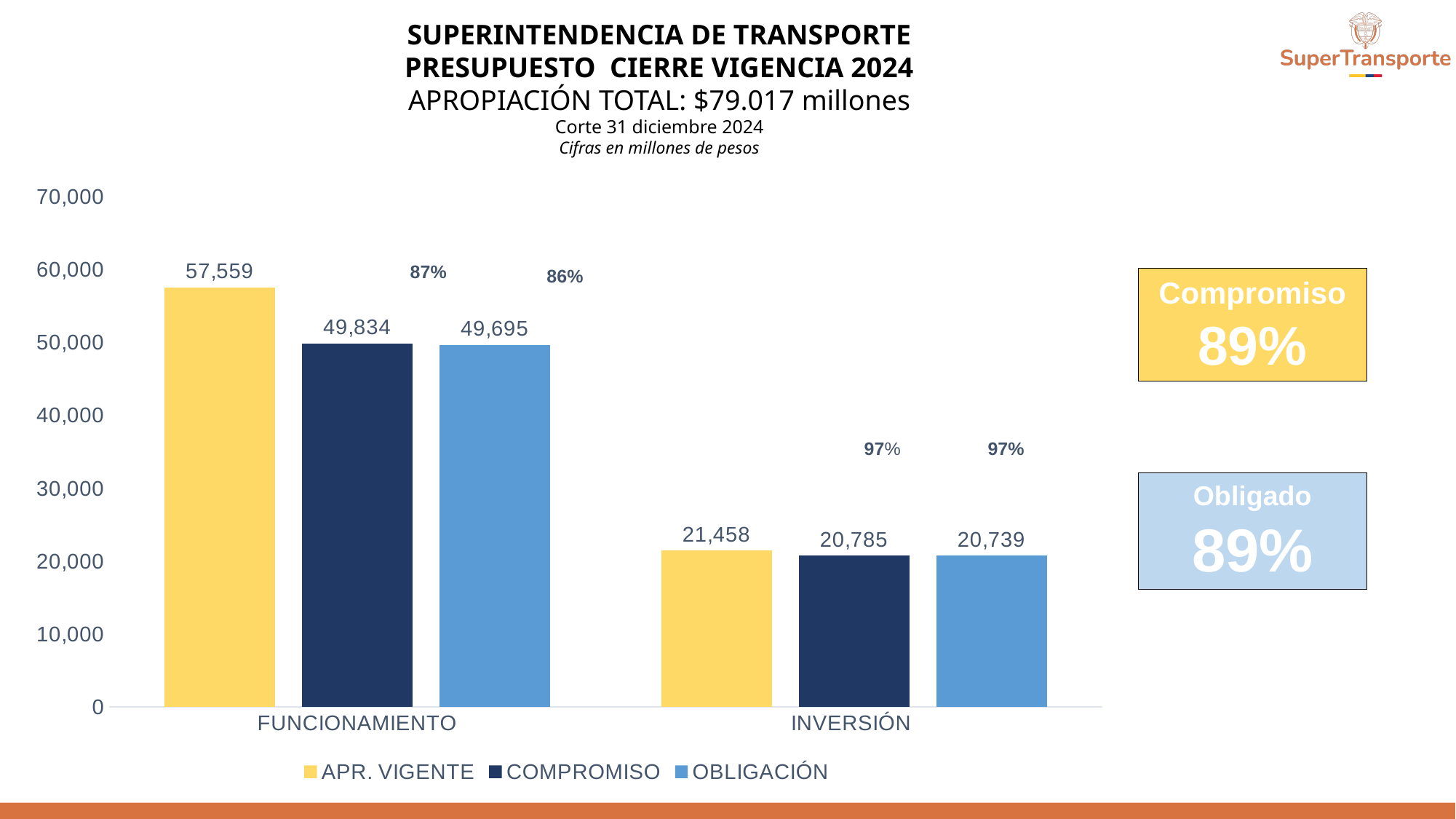
What is the OBLIGACIÓN value for FUNCIONAMIENTO? 49,695 What kind of chart is shown on the slide? Bar chart Which series has the lowest value for INVERSIÓN? OBLIGACIÓN How many series does the legend list? 3 How many categories are shown on the x axis? 2 What is the COMPROMISO value for INVERSIÓN? 20,785 Is the APR. VIGENTE value for INVERSIÓN greater or less than 20,000? greater What is the APR. VIGENTE value for FUNCIONAMIENTO? 57,559 What is the difference between the APR. VIGENTE and COMPROMISO values for FUNCIONAMIENTO? 7,725 Is the COMPROMISO value for FUNCIONAMIENTO larger than the OBLIGACIÓN value for FUNCIONAMIENTO? Yes Which category has the higher APR. VIGENTE value? FUNCIONAMIENTO What is the difference between the APR. VIGENTE values for FUNCIONAMIENTO and INVERSIÓN? 36,101